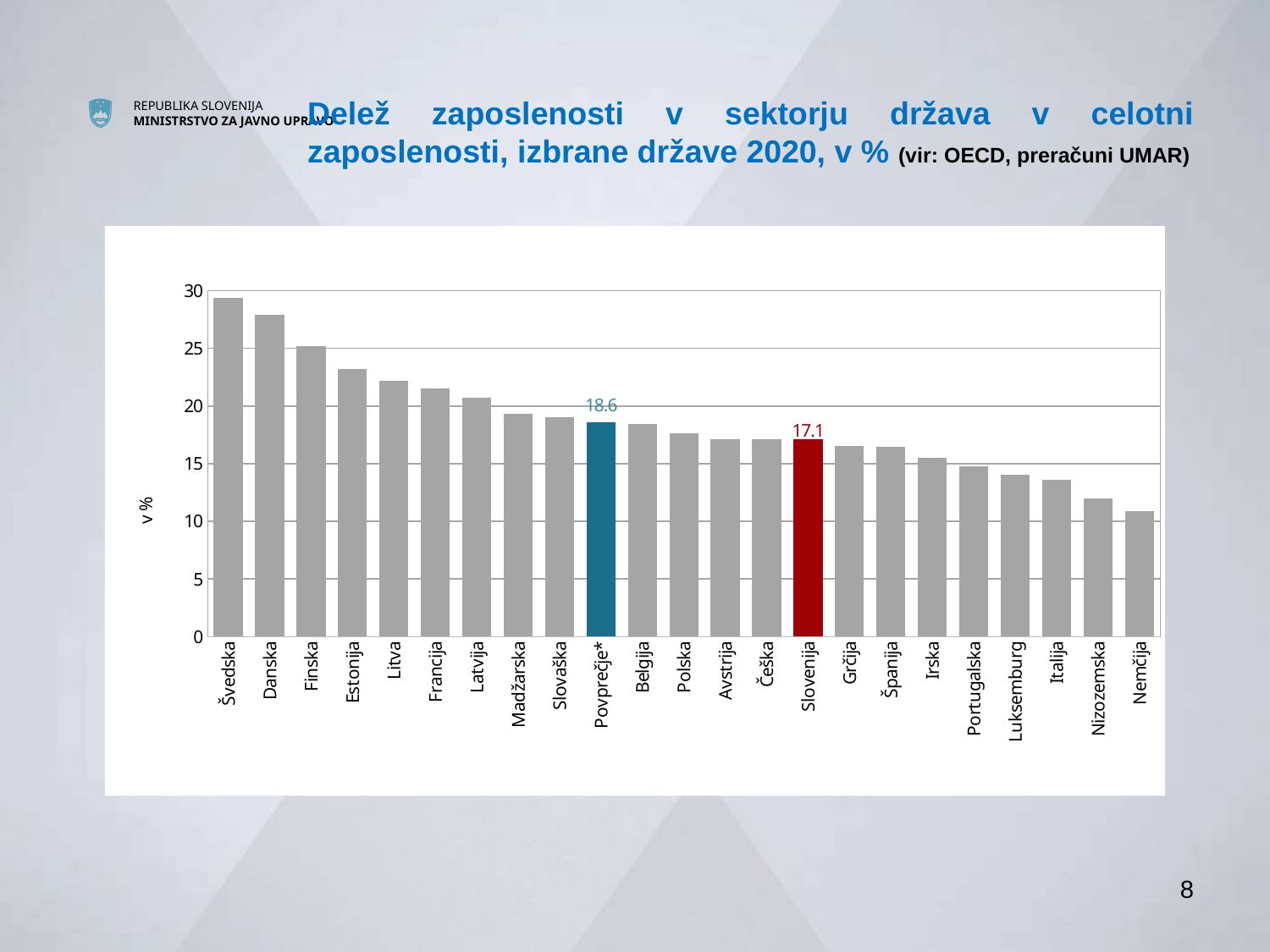
How many bars are shown in the chart? 23 Is the value for Švedska greater or less than 25? greater Which country has the highest bar? Švedska What is the value shown for Povprečje*? 18.6 Do the values rise or fall from left to right along the x axis? fall Which is larger, the value for Danska or the value for Italija? Danska What is the value shown for Slovenija? 17.1 Which country has the lowest bar? Nemčija Is the value for Italija greater or less than 15? less What is the difference between the value for Povprečje* and the value for Slovenija? 1.5 Is the value for Nemčija greater or less than 10? greater What kind of chart is shown on the slide? bar chart